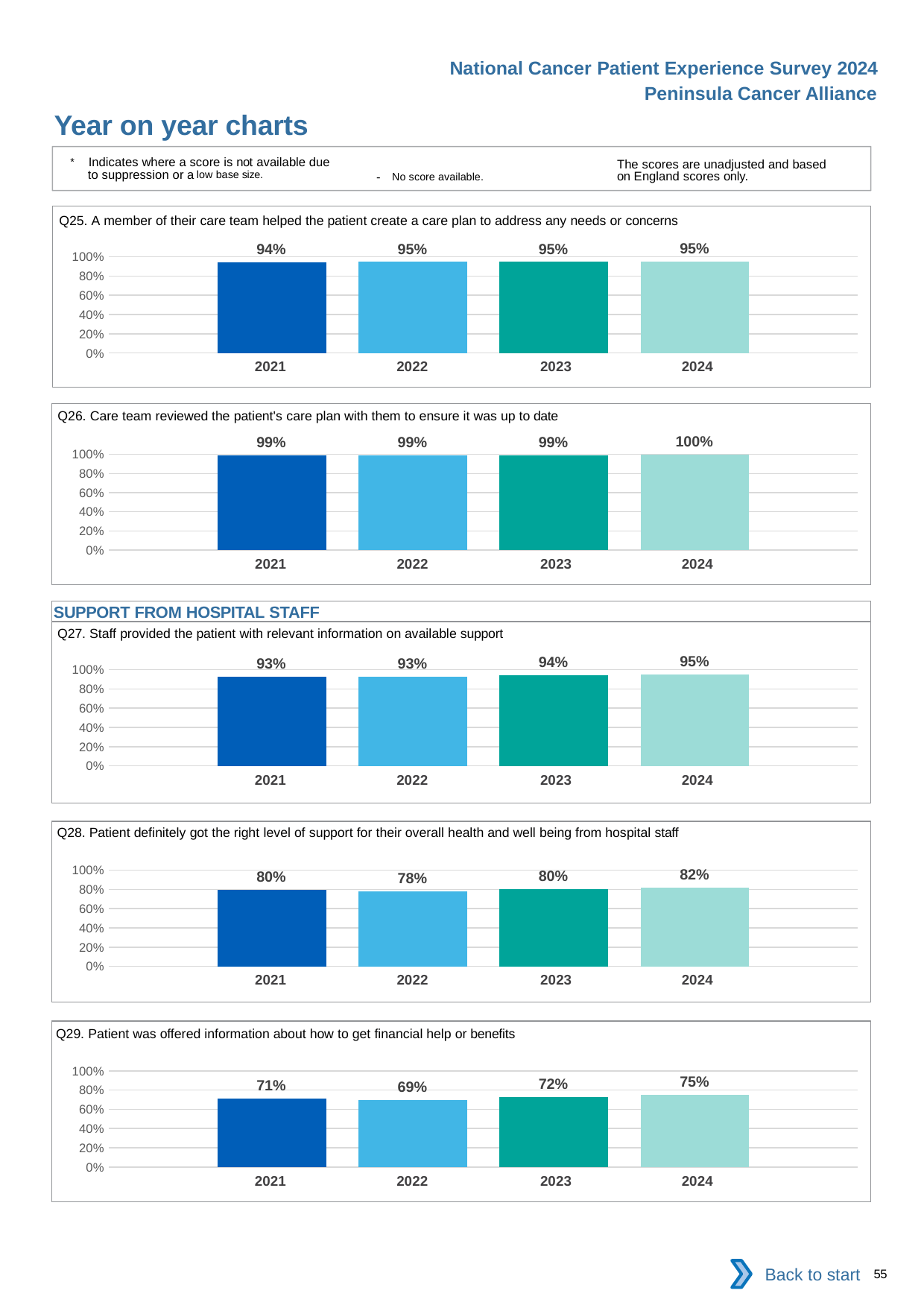
In the Q29 chart, what is the difference between the 2024 and 2022 values? 6% In the Q27 chart, which year has the highest value? 2024 In the Q26 chart, what is the value for 2024? 100% How many years are shown in the Q27 chart? 4 In the Q28 chart, which is larger, the value for 2024 or the value for 2022? 2024 In the Q29 chart, do the values rise or fall from 2022 to 2024? rise In the Q29 chart, is the value for 2021 greater or less than 80%? less What kind of chart is the Q25 chart? bar chart How many charts are shown on the slide? 5 In the Q28 chart, which year has the lowest value? 2022 In the Q27 chart, what is the value for 2023? 94% In the Q25 chart, what is the value for 2021? 94%